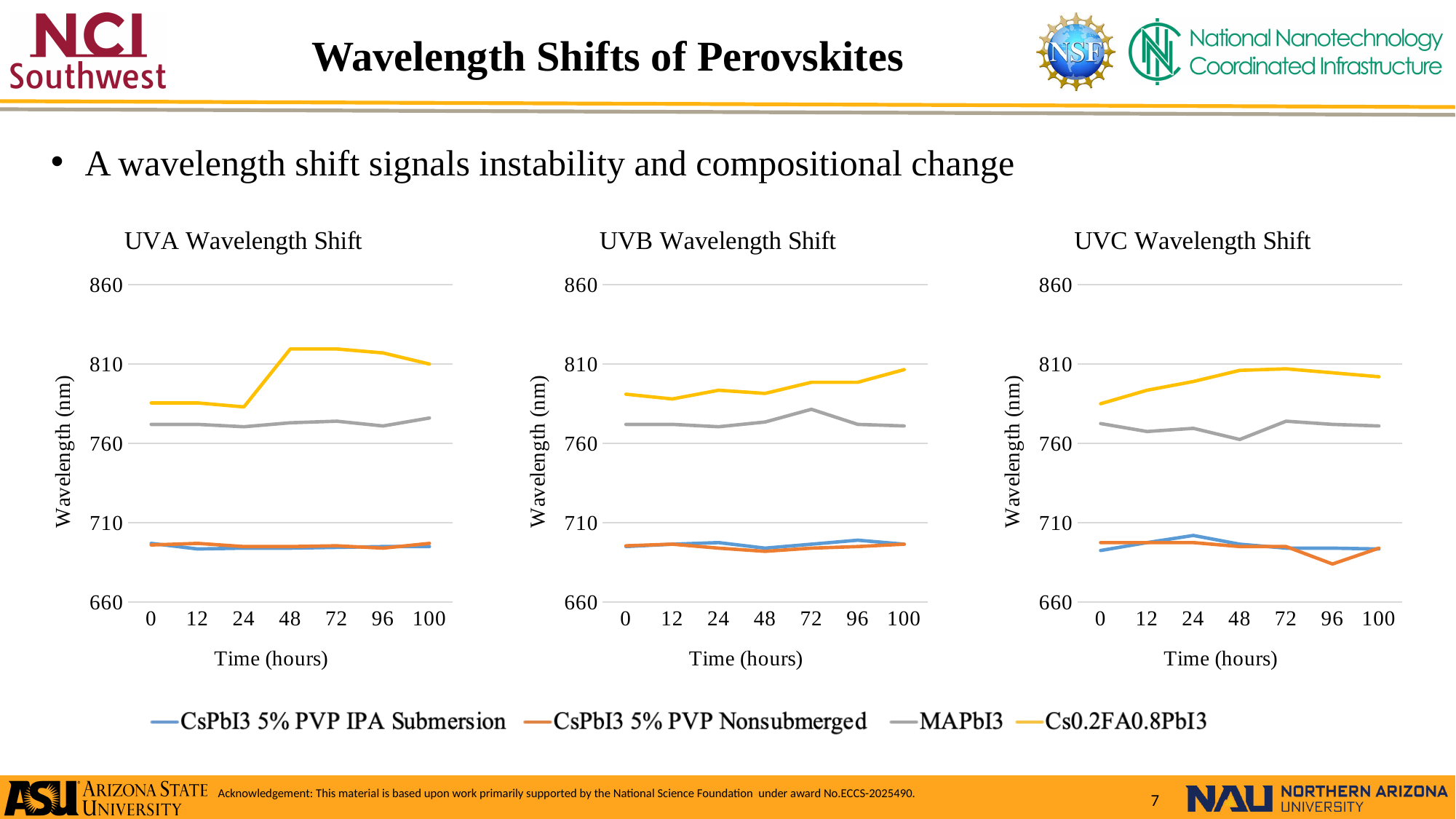
In the UVB Wavelength Shift chart, which series has the highest wavelength values? Cs0.2FA0.8PbI3 In the UVA Wavelength Shift chart, is the value for MAPbI3 at 0 hours greater or less than 760? greater What kind of chart is the UVA Wavelength Shift chart? line chart In the UVA Wavelength Shift chart, is the value for Cs0.2FA0.8PbI3 at 48 hours greater or less than 810? greater In the UVC Wavelength Shift chart, is the value for CsPbI3 5% PVP Nonsubmerged at 96 hours greater or less than 710? less In the UVB Wavelength Shift chart, does the Cs0.2FA0.8PbI3 line rise or fall overall from 0 to 100 hours? rise In the UVC Wavelength Shift chart, which series has the lowest value at 96 hours? CsPbI3 5% PVP Nonsubmerged How many time points are plotted along the x axis of the UVB Wavelength Shift chart? 7 How many series does the legend list for the charts? 4 In the UVA Wavelength Shift chart, which is larger at 48 hours: Cs0.2FA0.8PbI3 or MAPbI3? Cs0.2FA0.8PbI3 What is the y-axis label on the UVC Wavelength Shift chart? Wavelength (nm)